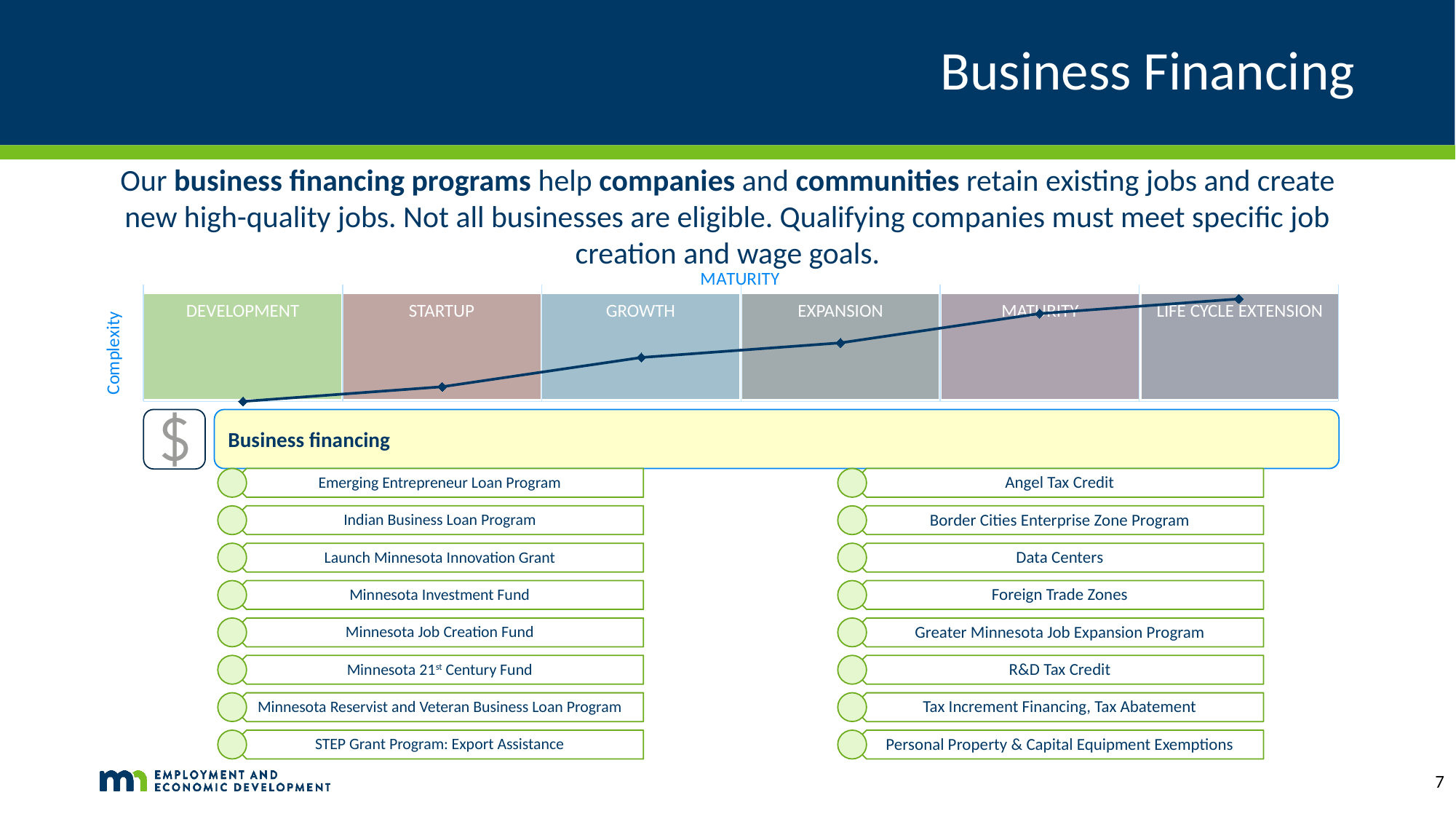
How many lines (series) are plotted on the chart? 1 Which stage has the lower plotted complexity, DEVELOPMENT or EXPANSION? DEVELOPMENT At which stage is the plotted complexity lowest? DEVELOPMENT Does the plotted line rise or fall as it moves from DEVELOPMENT to LIFE CYCLE EXTENSION? rises Which stage has the higher plotted complexity, STARTUP or GROWTH? GROWTH Which stage has the higher plotted complexity, EXPANSION or MATURITY? MATURITY How many stages (points) are plotted along the x axis of the chart? 6 At which stage is the plotted complexity highest? LIFE CYCLE EXTENSION What kind of chart is shown on the slide? line chart What is the label on the horizontal axis of the chart? MATURITY Which stage comes immediately after GROWTH on the x axis? EXPANSION What is the label on the vertical axis of the chart? Complexity